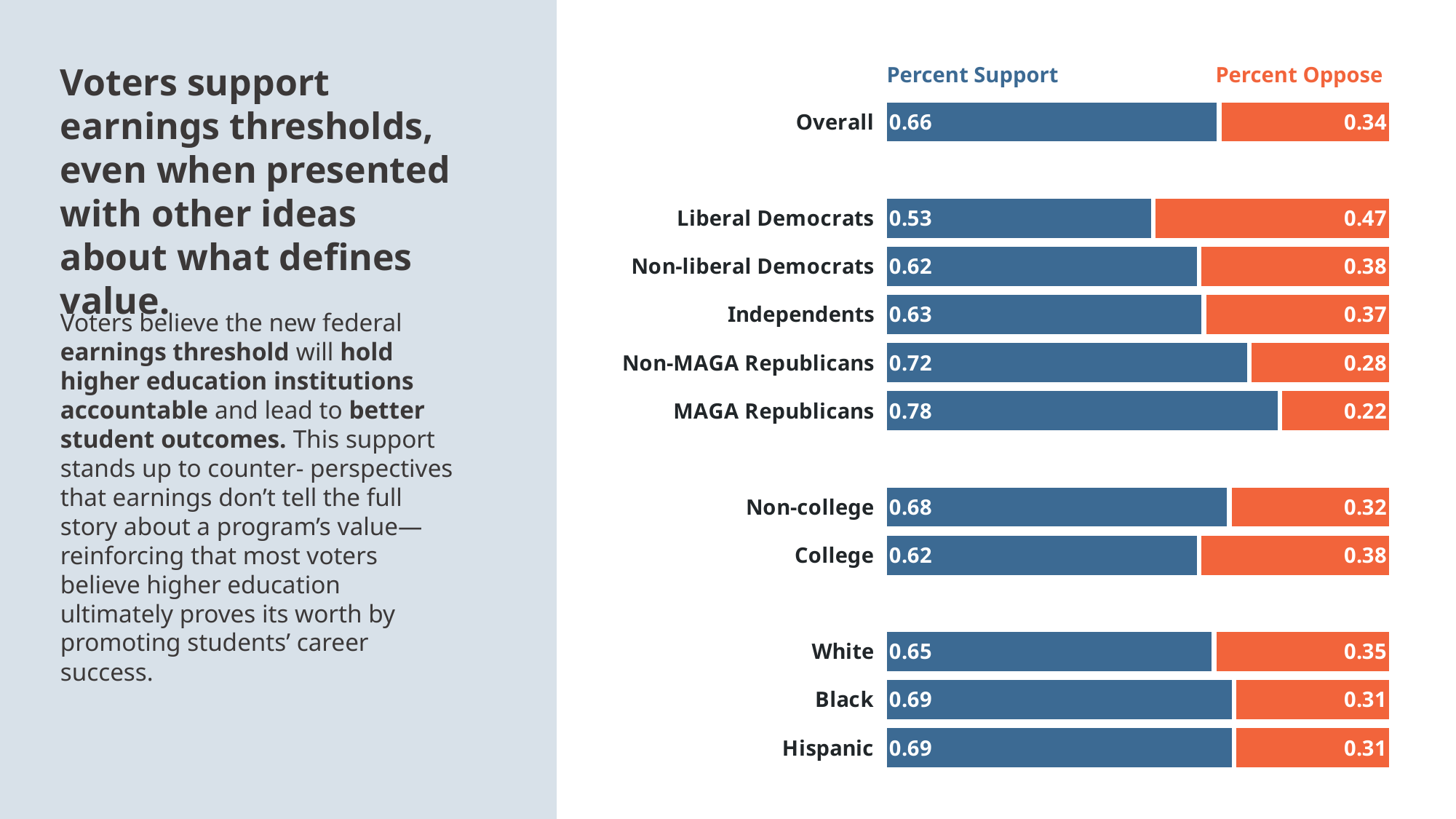
What is the Percent Support value for MAGA Republicans? 0.78 What is the Percent Oppose value for Liberal Democrats? 0.47 What is the difference in Percent Support between Non-college and College? 0.06 How many categories are shown in the chart? 11 Which has a higher Percent Support, Independents or Non-liberal Democrats? Independents How many series does the chart show? 2 Which category has the lowest Percent Support? Liberal Democrats What kind of chart is shown on the slide? Bar chart Which category has the highest Percent Support? MAGA Republicans What is the total of Percent Support and Percent Oppose for White? 1.00 What colour are the Percent Oppose bars? Orange What is the Percent Support value for Overall? 0.66